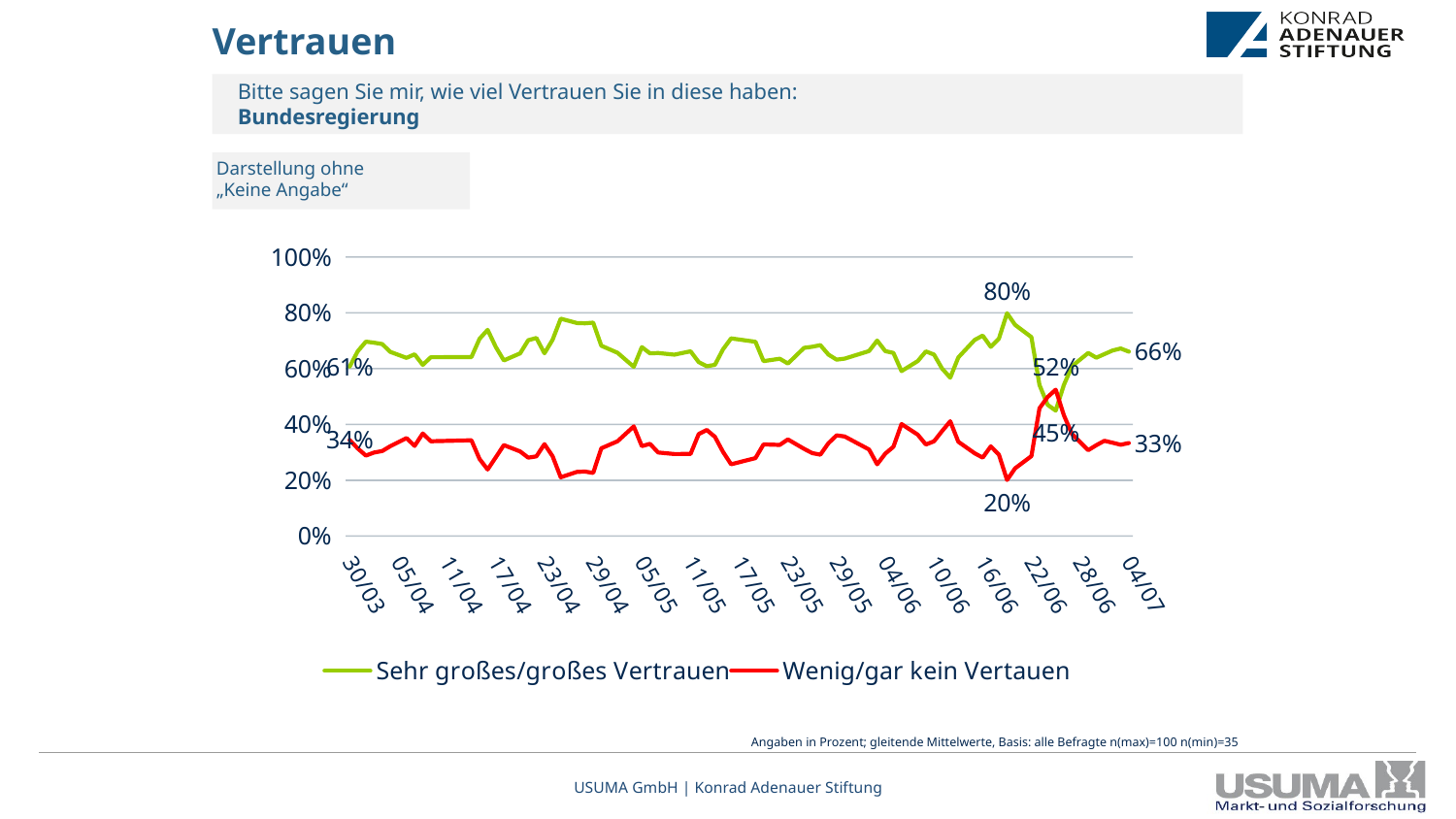
What is the highest labelled value of the 'Sehr großes/großes Vertrauen' series? 80% What is the last labelled value of the 'Sehr großes/großes Vertrauen' series at the right end of the chart? 66% What is the first labelled value of the 'Wenig/gar kein Vertauen' series at the start of the chart? 34% What is the first labelled value of the 'Sehr großes/großes Vertrauen' series at the start of the chart? 61% What is the lowest labelled value of the 'Wenig/gar kein Vertauen' series? 20% How many series does the legend list? 2 What is the last labelled value of the 'Wenig/gar kein Vertauen' series at the right end of the chart? 33% What is the difference between the final labelled values of the two series (66% and 33%)? 33 percentage points What colour is the line for 'Wenig/gar kein Vertauen'? red What is the difference between the first labelled values of the two series (61% and 34%)? 27 percentage points At the right end of the chart, which series has the higher value? Sehr großes/großes Vertrauen What kind of chart is shown on the slide? line chart